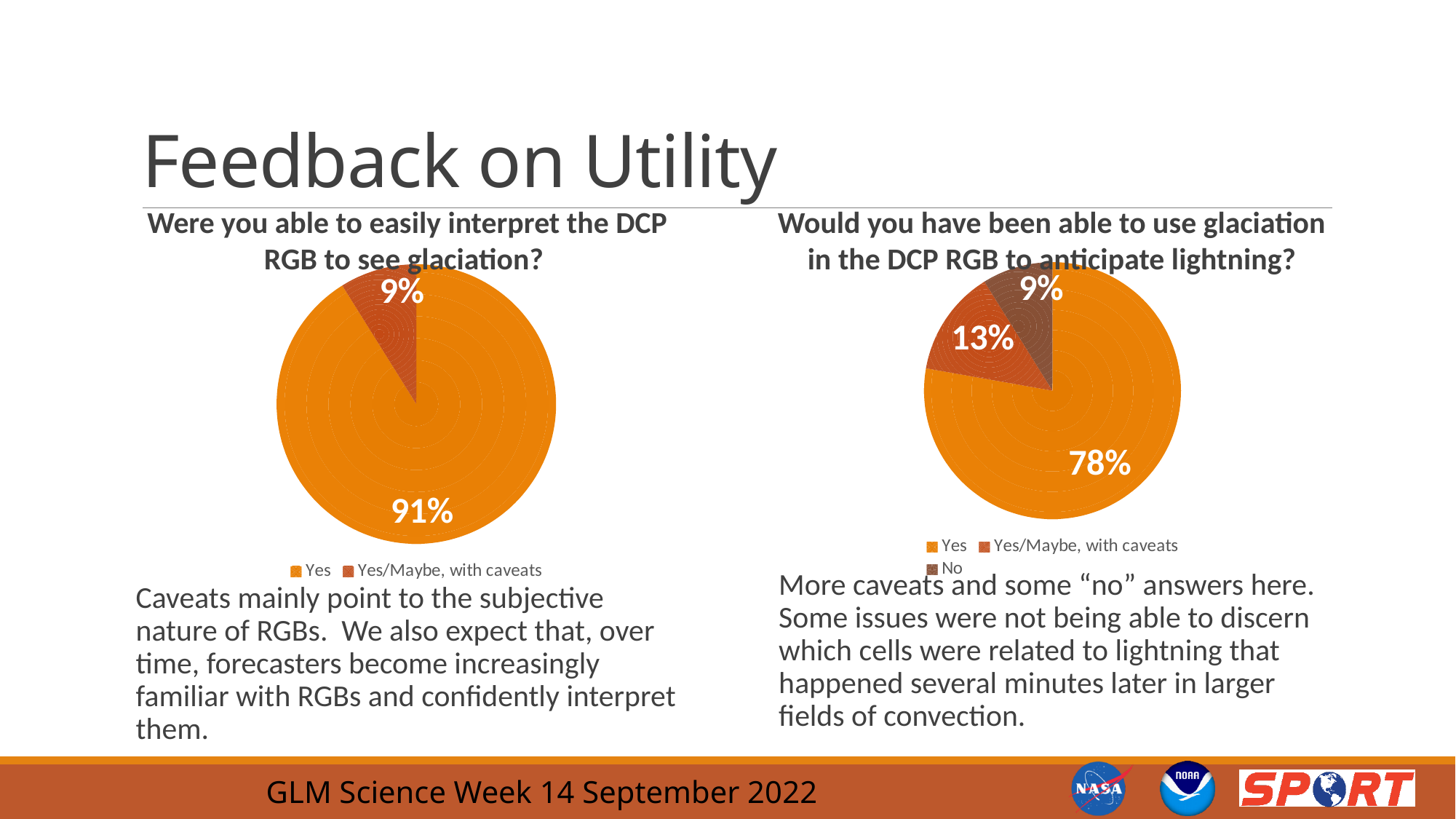
In the right chart, 'Would you have been able to use glaciation in the DCP RGB to anticipate lightning?', which response category has the smallest share? No In the right chart, 'Would you have been able to use glaciation in the DCP RGB to anticipate lightning?', what share of responses were 'Yes'? 78% What kind of chart is used for 'Were you able to easily interpret the DCP RGB to see glaciation?'? Pie chart How many categories does the legend of the right chart, 'Would you have been able to use glaciation in the DCP RGB to anticipate lightning?', list? 3 How many slices does the left chart, 'Were you able to easily interpret the DCP RGB to see glaciation?', have? 2 In the right chart, 'Would you have been able to use glaciation in the DCP RGB to anticipate lightning?', what share of responses were 'Yes/Maybe, with caveats'? 13% In the left chart, 'Were you able to easily interpret the DCP RGB to see glaciation?', what share of responses were 'Yes/Maybe, with caveats'? 9% In the right chart, 'Would you have been able to use glaciation in the DCP RGB to anticipate lightning?', what is the difference in percentage points between the 'Yes' and 'Yes/Maybe, with caveats' shares? 65 In the left chart, 'Were you able to easily interpret the DCP RGB to see glaciation?', what share of responses were 'Yes'? 91% In the right chart, 'Would you have been able to use glaciation in the DCP RGB to anticipate lightning?', what share of responses were 'No'? 9% In the left chart, 'Were you able to easily interpret the DCP RGB to see glaciation?', which response category has the largest share? Yes In the left chart, 'Were you able to easily interpret the DCP RGB to see glaciation?', what is the difference in percentage points between the 'Yes' and 'Yes/Maybe, with caveats' shares? 82